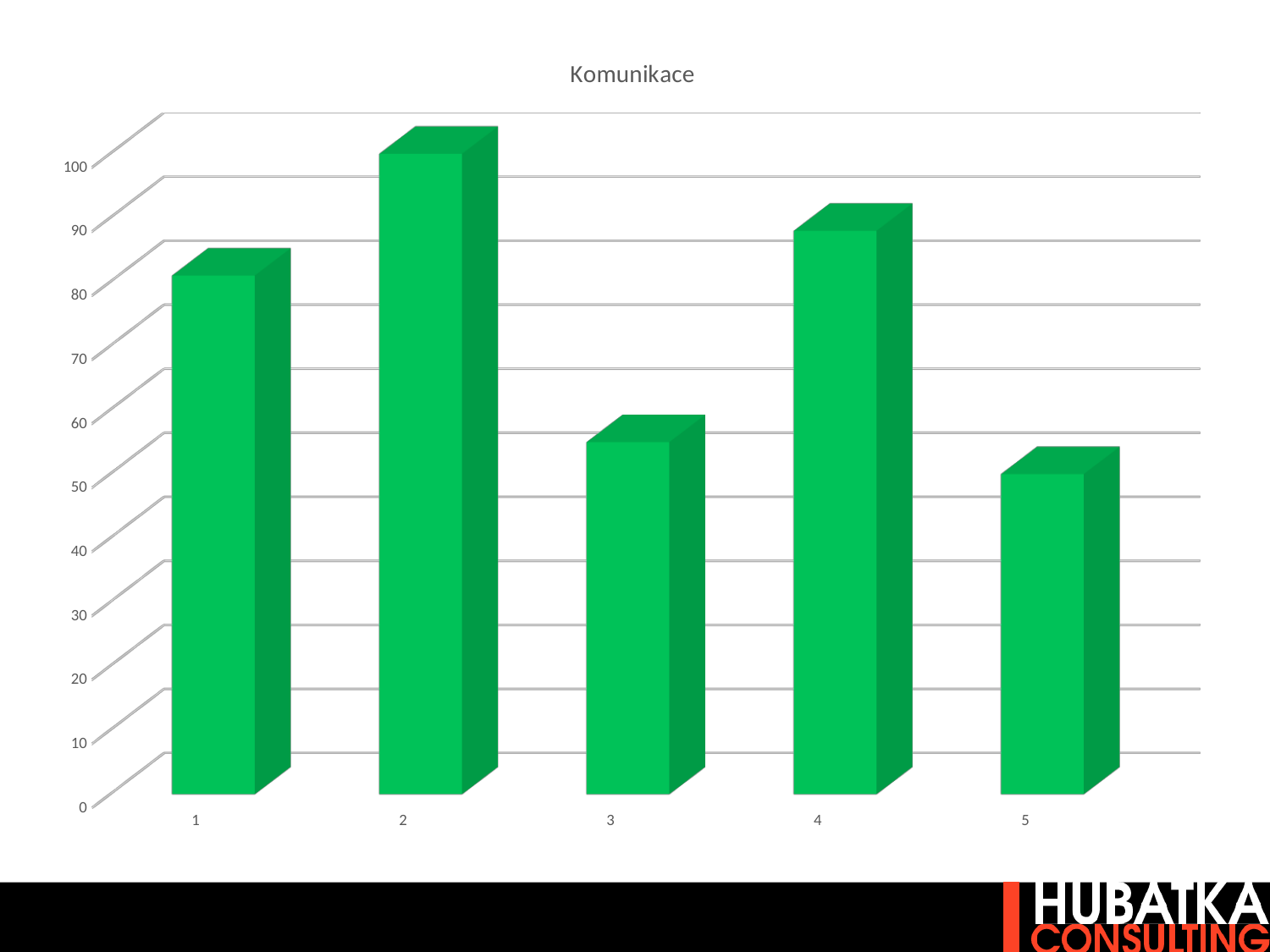
What kind of chart is shown on the slide? bar chart What is the title of the chart? Komunikace Is the value for category 4 greater or less than 80? greater How many categories are shown on the x axis of the chart? 5 Is the value for category 2 greater or less than 90? greater Which is larger, the value for category 3 or the value for category 1? 1 Is the value for category 1 greater or less than 70? greater Which is larger, the value for category 4 or the value for category 5? 4 Which category has the highest bar in the chart? 2 Which category has the lowest bar in the chart? 5